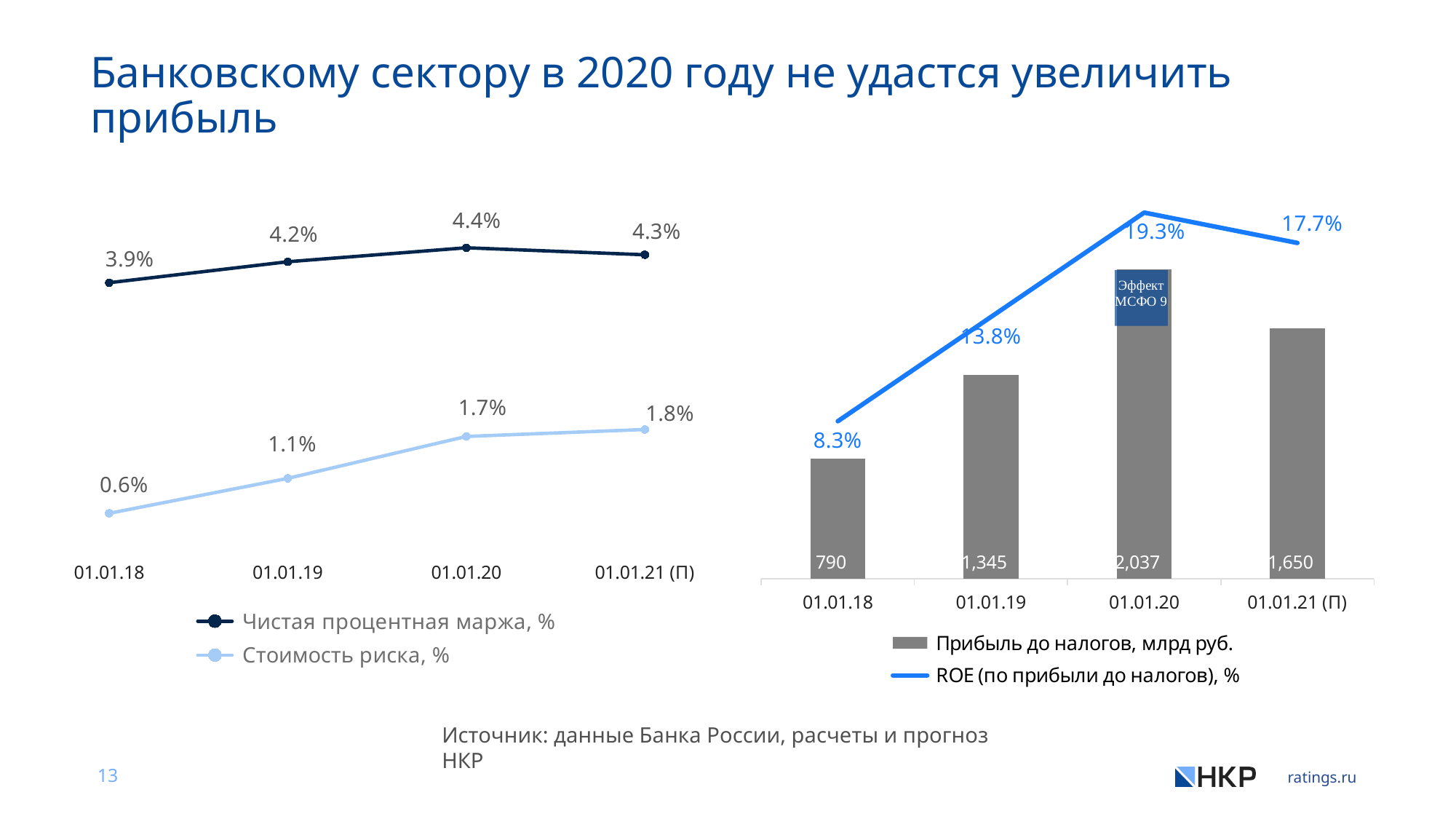
In the left chart, at which date is Чистая процентная маржа, % lowest? 01.01.18 How many dates are shown on the x axis of the right chart? 4 In the left chart, does Стоимость риска, % rise or fall from 01.01.18 to 01.01.21 (П)? rise In the left chart, at which date is Стоимость риска, % highest? 01.01.21 (П) In the left chart, what is the value of Чистая процентная маржа, % at 01.01.20? 4.4% In the right chart, what is the difference in Прибыль до налогов, млрд руб. between 01.01.20 and 01.01.21 (П)? 387 In the right chart, what is the ROE (по прибыли до налогов), % value at 01.01.21 (П)? 17.7% How many series does the legend of the left chart list? 2 In the right chart, at which date is Прибыль до налогов, млрд руб. highest? 01.01.20 In the left chart, what is the difference between Чистая процентная маржа, % and Стоимость риска, % at 01.01.19? 3.1% In the left chart, what is the value of Стоимость риска, % at 01.01.18? 0.6% In the right chart, what is the value of Прибыль до налогов, млрд руб. at 01.01.19? 1,345